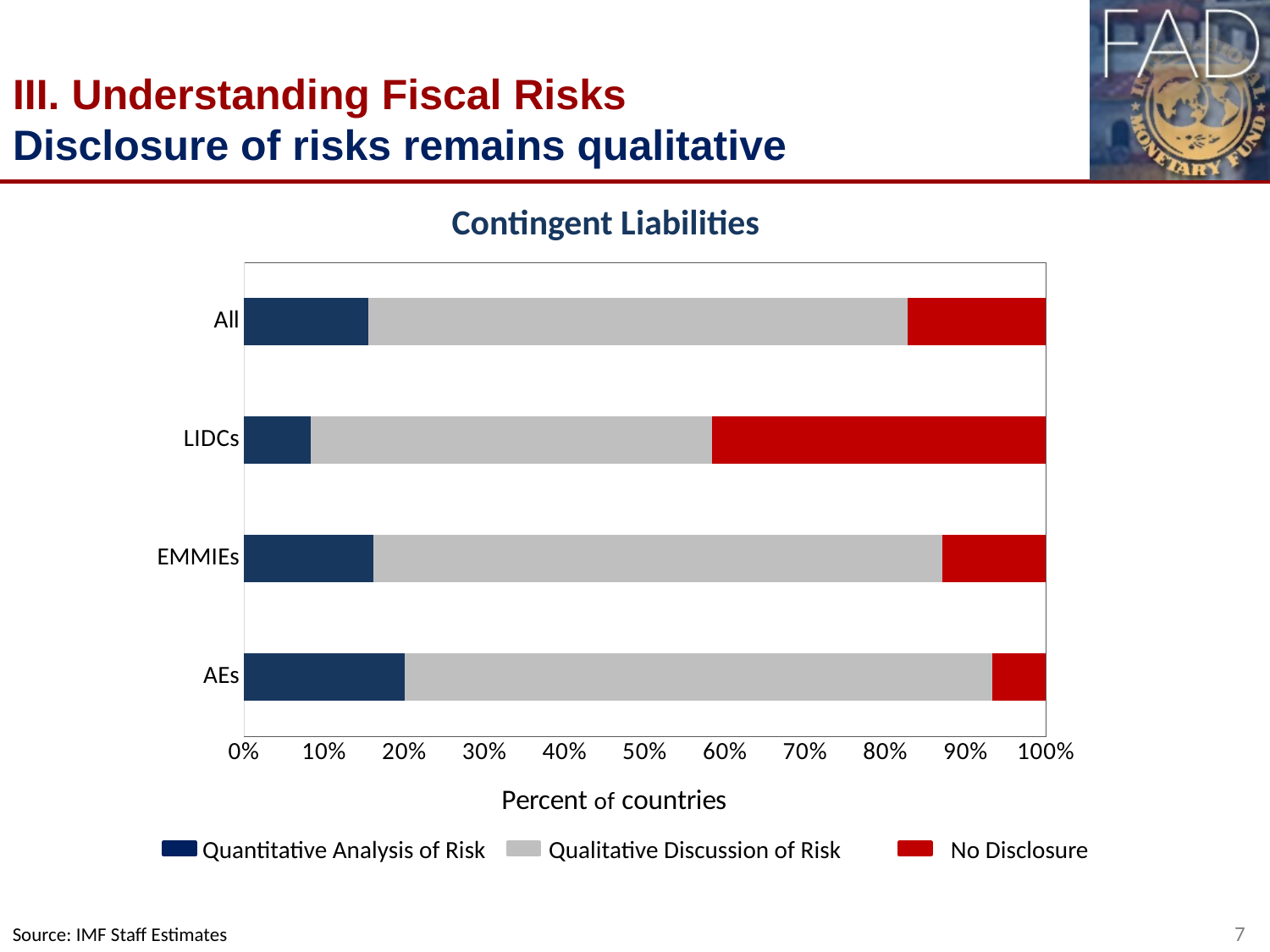
Which country group has the smallest No Disclosure segment? AEs What kind of chart is shown on the slide? Stacked bar chart Which country group has the largest No Disclosure segment? LIDCs Is the Quantitative Analysis of Risk share for AEs greater or less than 10%? greater Is the No Disclosure share for LIDCs greater or less than 30%? greater Which is larger: the Quantitative Analysis of Risk share for AEs or for LIDCs? AEs Which series is shown in red in the legend? No Disclosure Which country group has the largest Quantitative Analysis of Risk segment? AEs How many series does the legend list? 3 How many country groups (categories) are plotted on the chart? 4 What is the title of the chart? Contingent Liabilities Is the Quantitative Analysis of Risk share for LIDCs greater or less than 20%? less